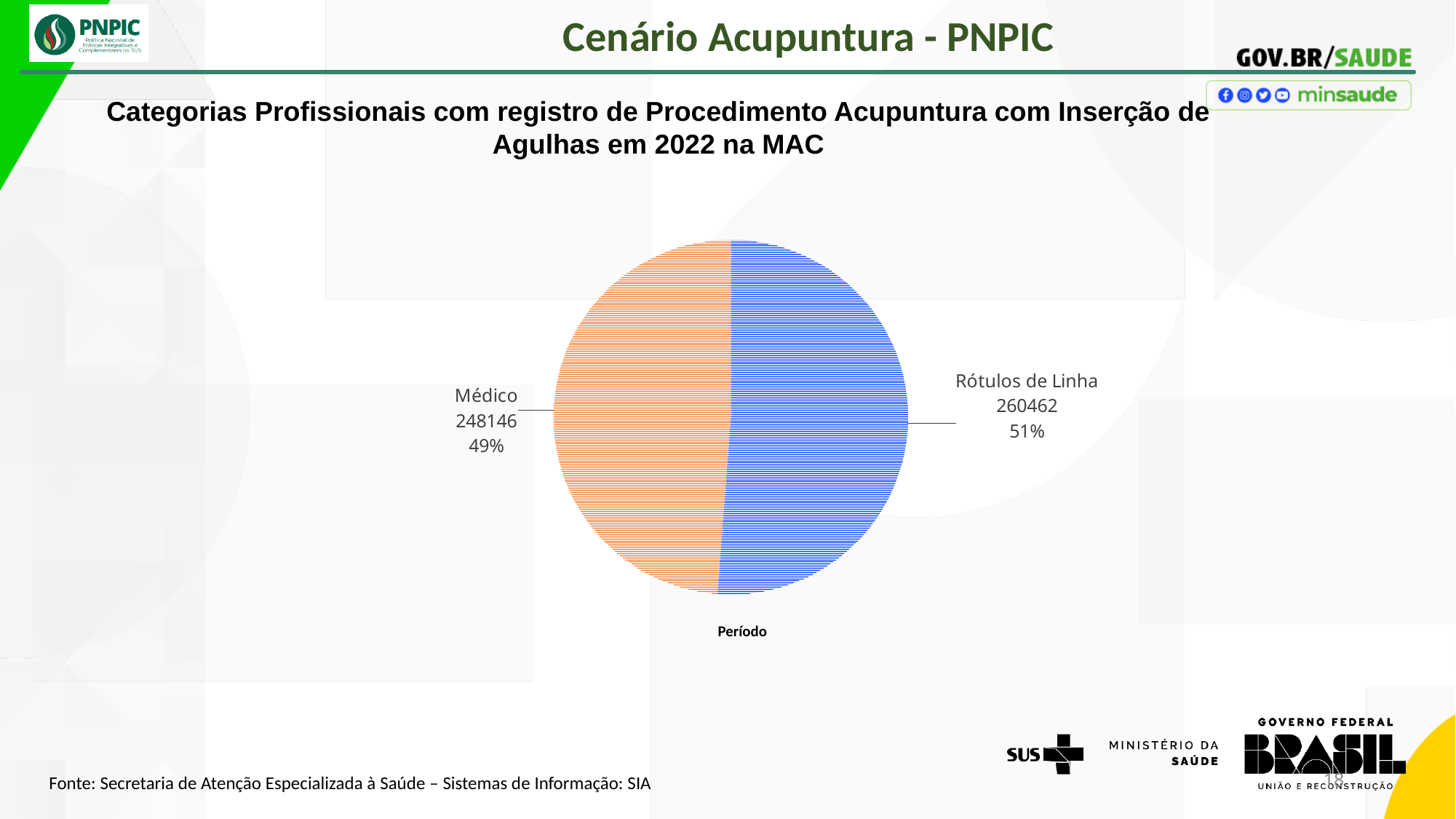
Which is larger, the value for Médico or the value for Rótulos de Linha? Rótulos de Linha What is the value shown for the Médico slice? 248146 Which slice is the largest in the pie chart? Rótulos de Linha What kind of chart is shown on the slide? pie chart What percentage share does the slice labelled Rótulos de Linha have? 51% What is the difference between the value for Rótulos de Linha and the value for Médico? 12316 Which slice is the smallest in the pie chart? Médico What percentage share does the Médico slice have? 49% What text appears directly below the pie chart? Período How many slices does the pie chart have? 2 What colour is the Médico slice? orange What is the value shown for the slice labelled Rótulos de Linha? 260462